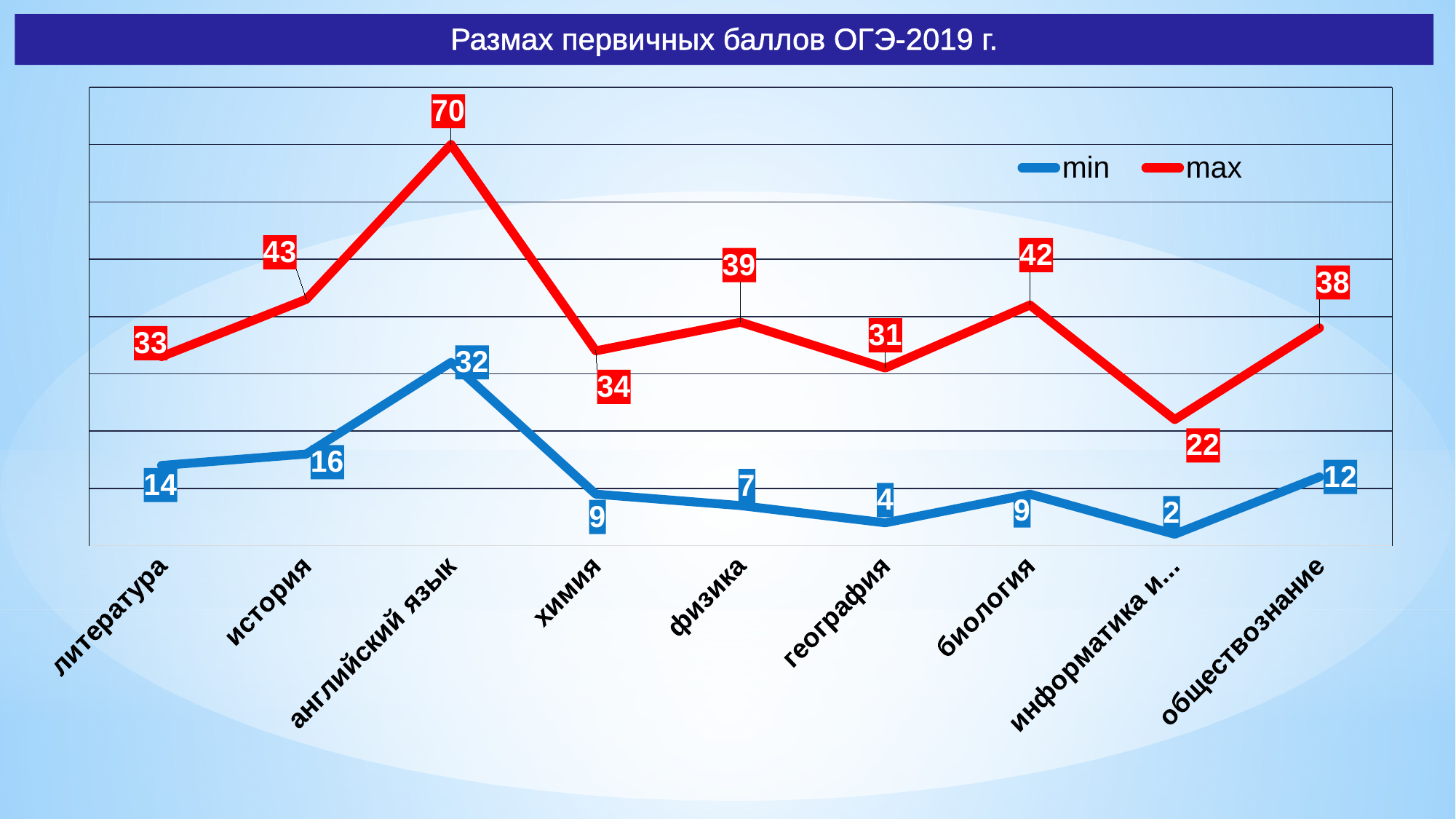
What is the difference between the max values for история and литература? 10 Which category has the lowest max value? информатика и... What is the difference between the max and min values for химия? 25 What is the min value for география? 4 What is the max value for биология? 42 Which is larger, the min value for обществознание or the min value for биология? обществознание What is the max value for английский язык? 70 Which category has the lowest min value? информатика и... What kind of chart is shown on the slide? line chart How many categories are shown on the x axis? 9 Which category has the highest max value? английский язык How many series does the legend list? 2